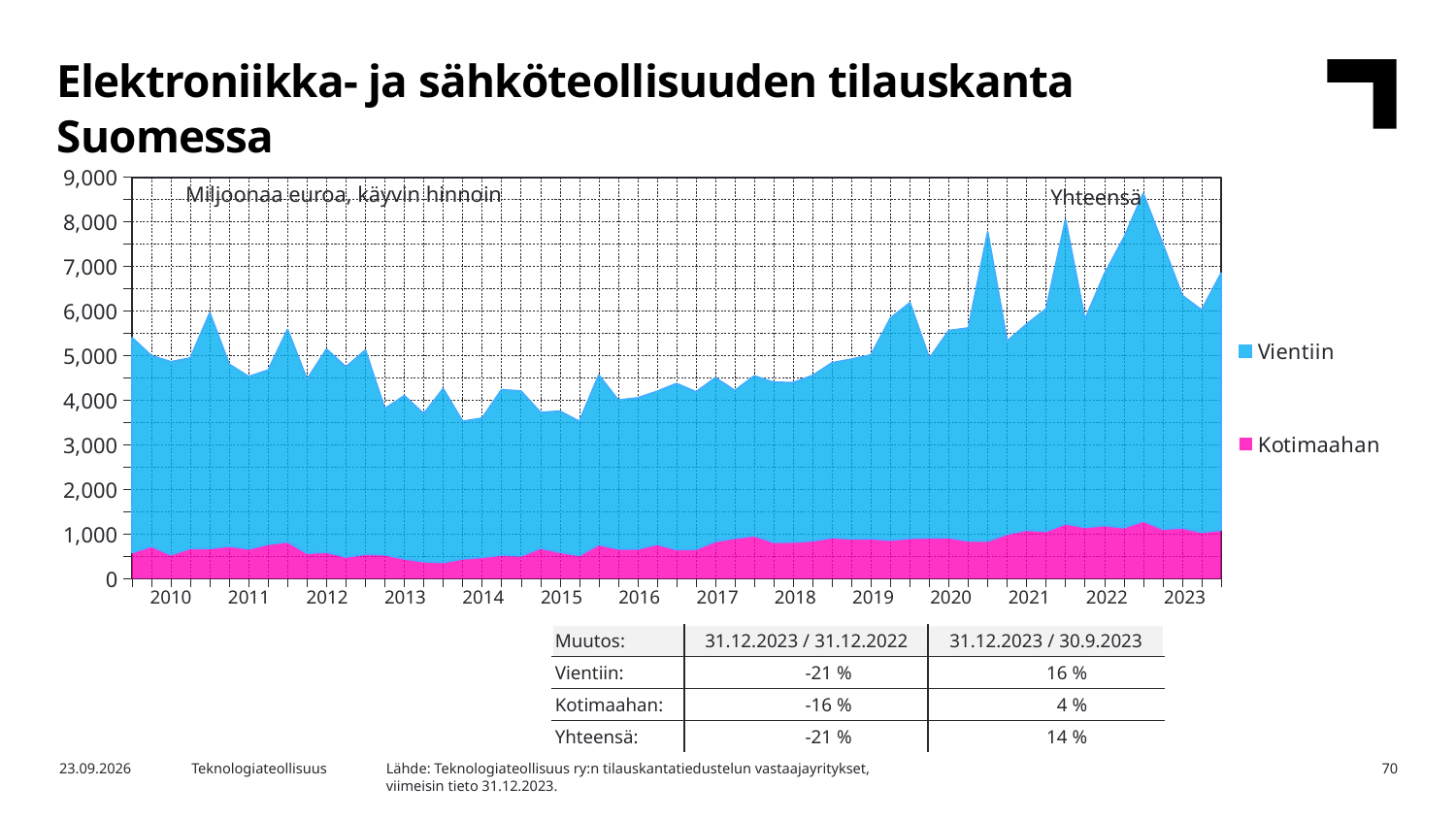
Is the Kotimaahan value in 2010 greater or less than 1,000? less What unit label is shown inside the chart area at the top left? Miljoonaa euroa, käyvin hinnoin Does the total (Yhteensä) value generally rise or fall from 2019 to 2022? rise How many years are labelled on the x axis? 14 Is the Kotimaahan value in 2022 greater or less than 2,000? less Is the total (Yhteensä) value in 2014 greater or less than 5,000? less Which series is larger throughout the chart, Vientiin or Kotimaahan? Vientiin How many series does the legend list? 2 In which year does the total (Yhteensä) reach its highest point? 2022 What are the two series named in the legend? Vientiin and Kotimaahan What kind of chart is shown on the slide? Stacked area chart